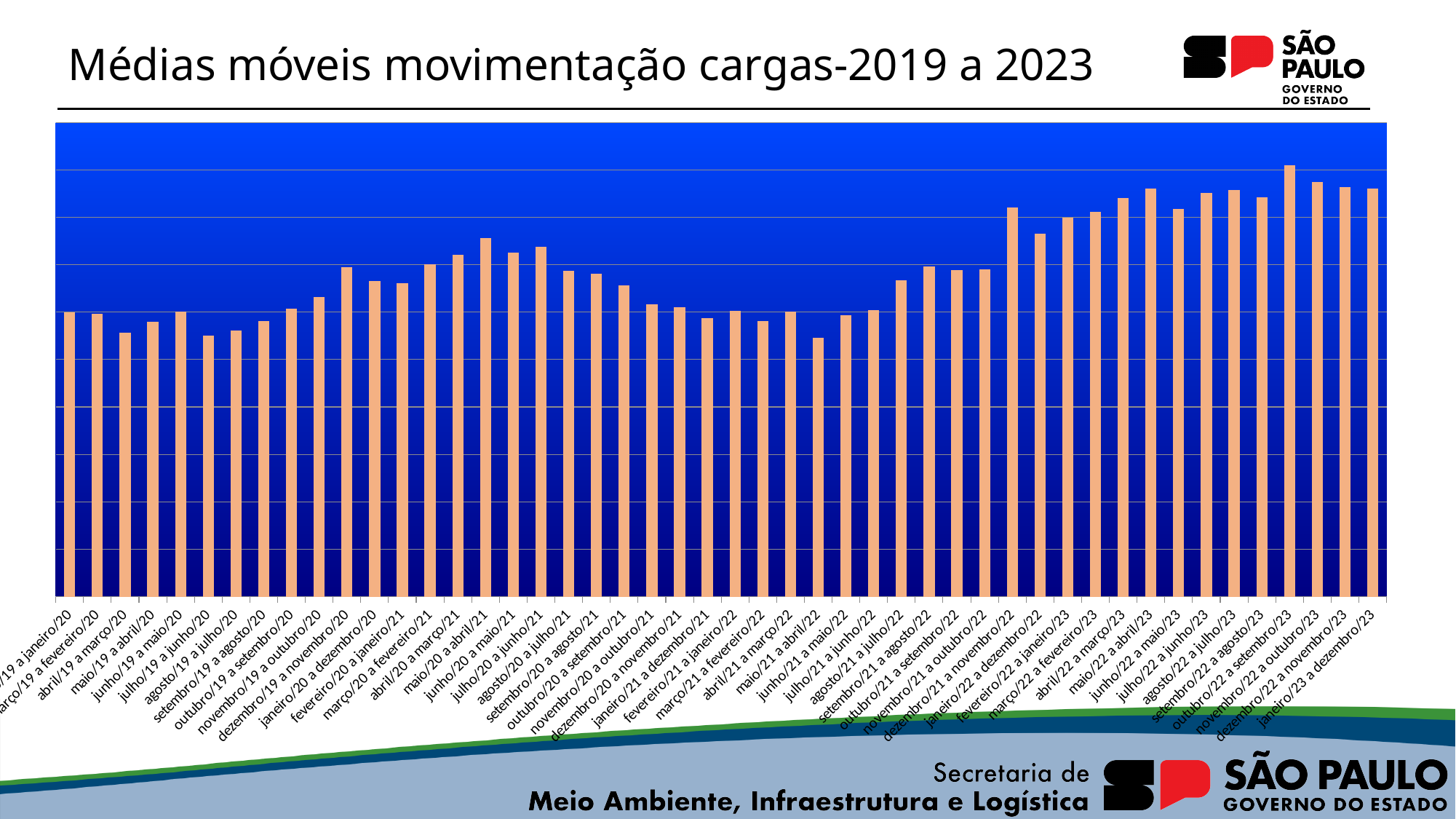
What colour are the bars in the chart? Light orange (peach) Within the 2022–2023 periods, which is taller: outubro/22 a setembro/23 or fevereiro/22 a janeiro/23? outubro/22 a setembro/23 Are the bars at the right end of the chart (2022–2023 periods) higher or lower than the bars at the left end (2019–2020 periods)? Higher Which bar is taller: junho/20 a maio/21 or janeiro/20 a dezembro/20? junho/20 a maio/21 Which bar is taller: maio/21 a abril/22 or outubro/21 a setembro/22? outubro/21 a setembro/22 How many data series are plotted in the chart? 1 What is the title of the chart on the slide? Médias móveis movimentação cargas-2019 a 2023 What kind of chart is shown on the slide? Bar chart How many bars (moving-average periods) are plotted in the chart? 48 Which period has the highest bar in the chart? outubro/22 a setembro/23